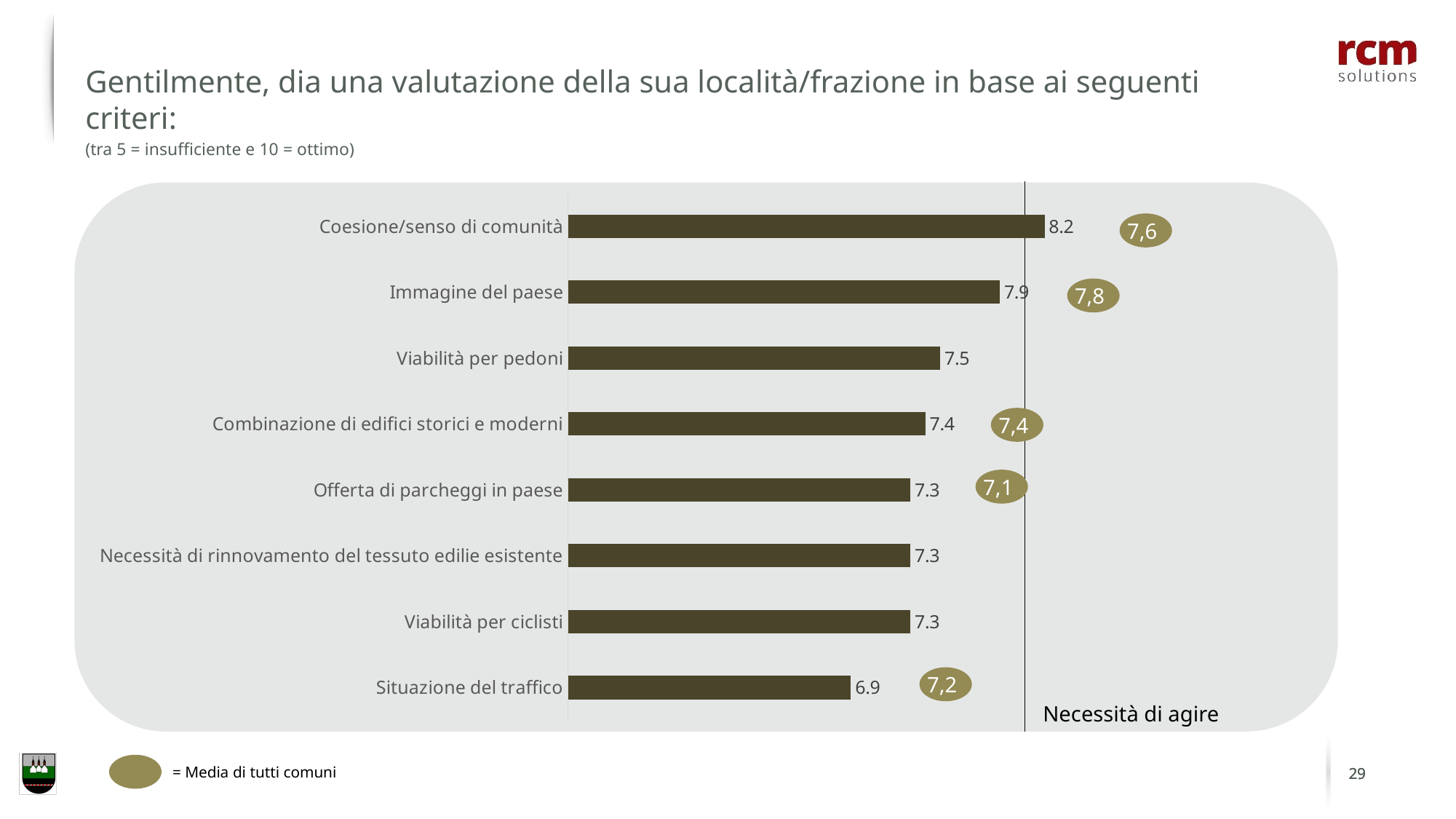
Which category has the lowest value? Situazione del traffico Which category has the highest value? Coesione/senso di comunità Which is larger, the value for "Immagine del paese" or the value for "Viabilità per pedoni"? Immagine del paese What is the difference between the values for "Coesione/senso di comunità" and "Situazione del traffico"? 1.3 What is the value for "Offerta di parcheggi in paese"? 7.3 What is the value for "Coesione/senso di comunità"? 8.2 What is the value for "Situazione del traffico"? 6.9 What is the value for "Viabilità per pedoni"? 7.5 How many categories are plotted in the chart? 8 What kind of chart is shown on the slide? bar chart According to the legend at the bottom, what does the oval marker represent? Media di tutti comuni What is the average of all municipalities (oval marker) shown next to "Coesione/senso di comunità"? 7,6